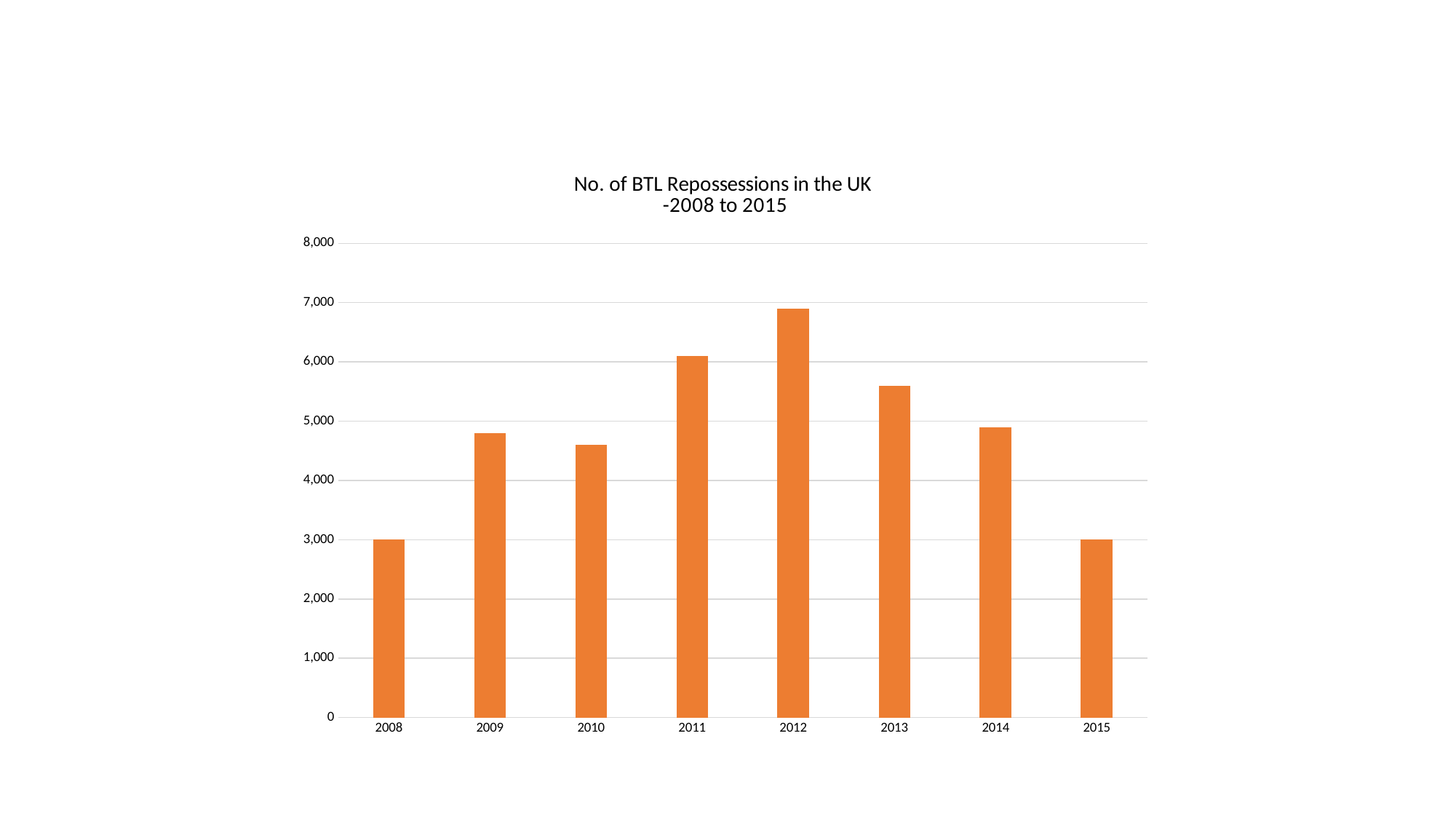
Is the value for 2013 greater or less than 6,000? less Do the values rise or fall from 2012 to 2015? fall What kind of chart is shown on the slide? bar chart What is the number of BTL repossessions in 2015? 3,000 What is the title of the chart? No. of BTL Repossessions in the UK -2008 to 2015 What is the number of BTL repossessions in 2008? 3,000 Which year has the highest number of BTL repossessions? 2012 Which year has the larger number of BTL repossessions, 2011 or 2013? 2011 How many years are shown on the x axis of the chart? 8 Is the value for 2012 greater or less than 6,000? greater Is the value for 2010 greater or less than 4,000? greater